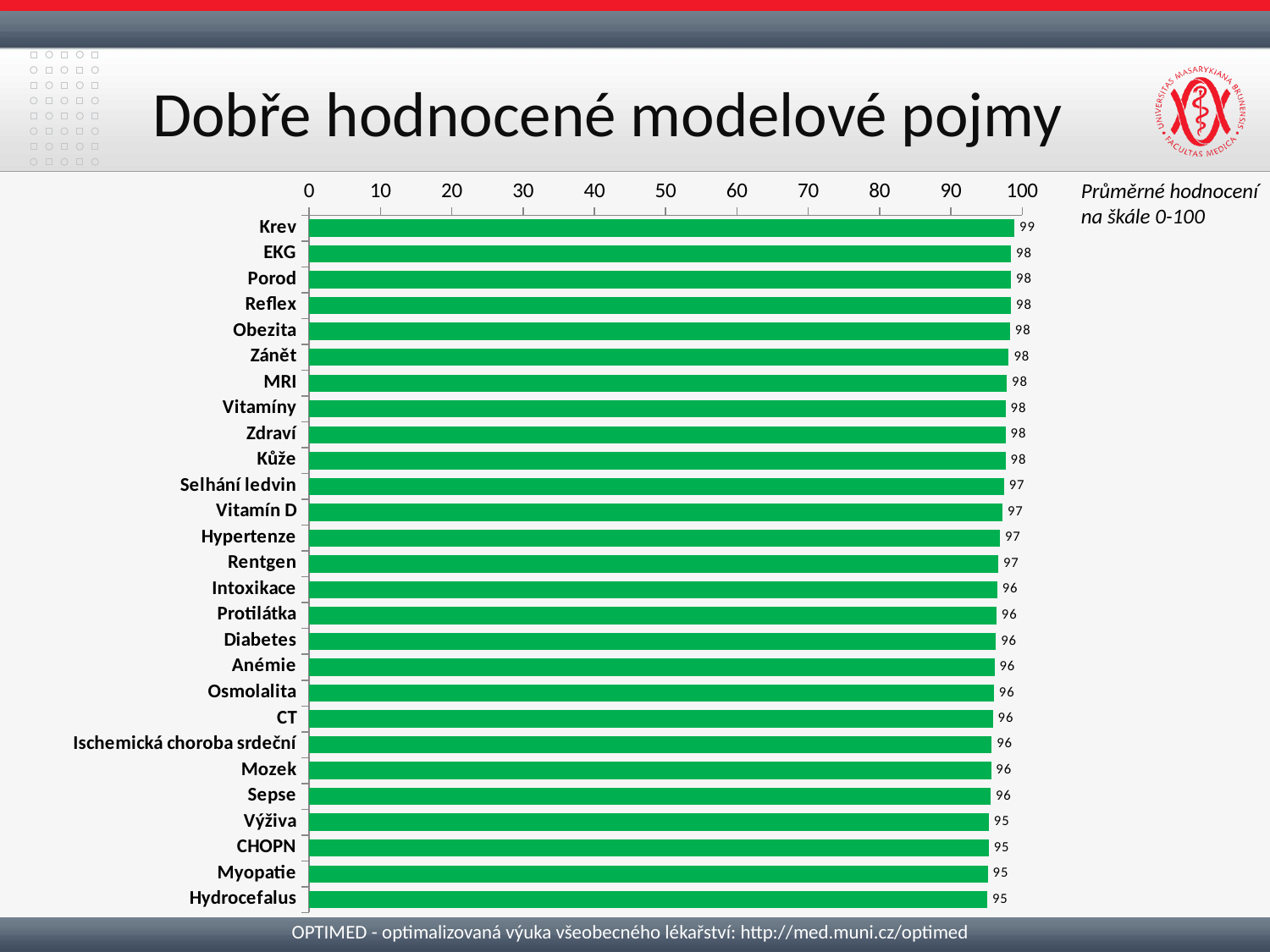
What is the value for Hypertenze? 97 What is the title of the slide? Dobře hodnocené modelové pojmy What is the value for Diabetes? 96 What is the lowest value shown on the chart? 95 What is the value for Krev? 99 Which category has the highest value? Krev Is the value for Sepse greater or less than 90? greater Which has a larger value, Krev or Výživa? Krev What is the difference between the values for Krev and Hydrocefalus? 4 How many categories are shown on the chart? 27 What kind of chart is shown on the slide? bar chart What is the value for Hydrocefalus? 95